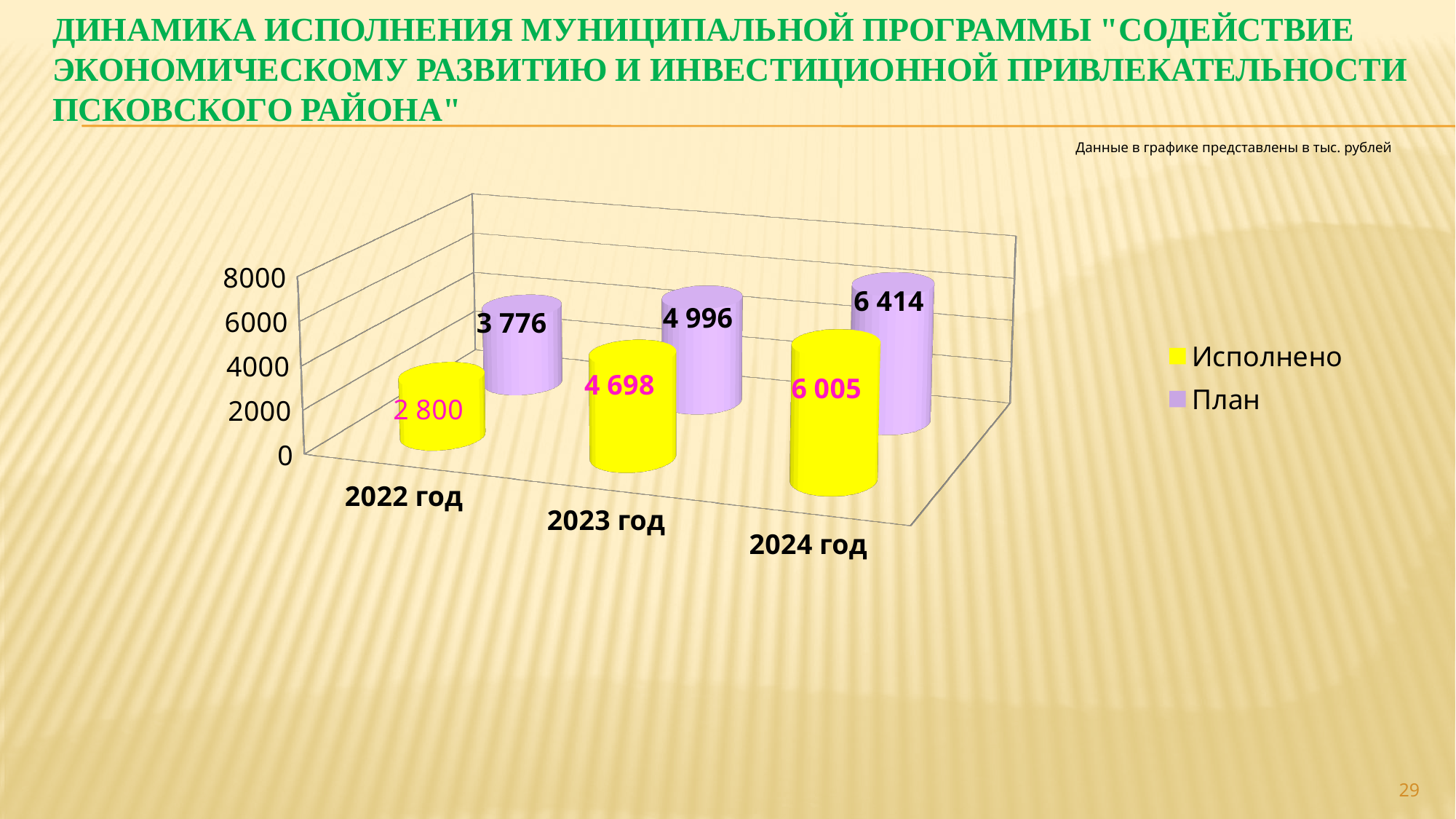
What is the value of План for 2022 год? 3 776 How many series does the legend list? 2 What is the value of Исполнено for 2024 год? 6 005 What is the value of План for 2023 год? 4 996 Which is larger for 2023 год, Исполнено or План? План Does the Исполнено value rise or fall from 2022 год to 2024 год? rise How many years are shown on the x axis? 3 In which year is the План value highest? 2024 год What is the difference between План and Исполнено for 2022 год? 976 What is the value of Исполнено for 2022 год? 2 800 In which year is the Исполнено value lowest? 2022 год What is the difference between План and Исполнено for 2024 год? 409